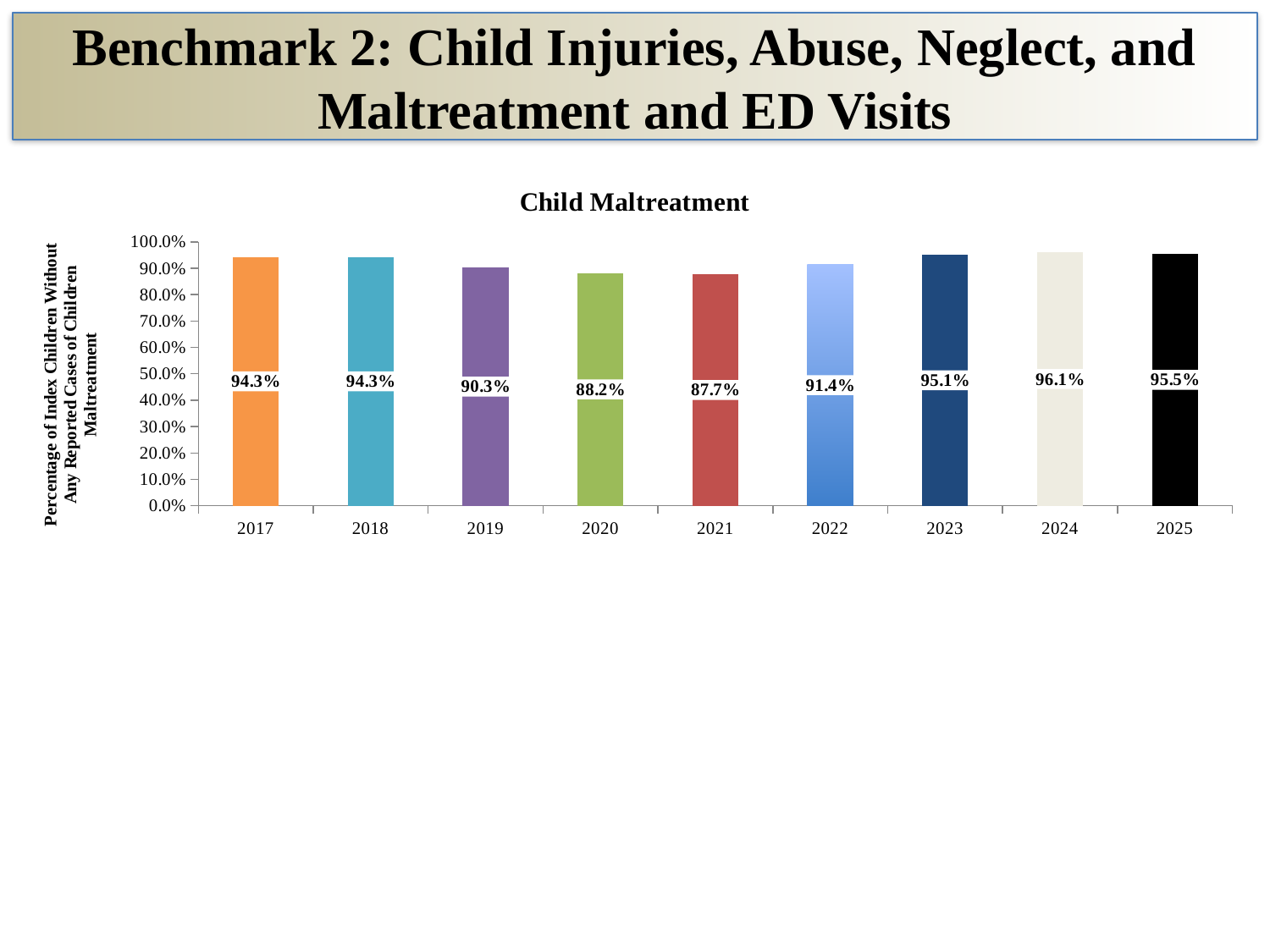
Which year has the highest value in the Child Maltreatment chart? 2024 Which year has the lowest value in the Child Maltreatment chart? 2021 Which is larger in the Child Maltreatment chart, the value for 2019 or the value for 2020? 2019 What is the value for 2021 in the Child Maltreatment chart? 87.7% What is the difference between the values for 2024 and 2021 in the Child Maltreatment chart? 8.4% What is the difference between the values for 2023 and 2022 in the Child Maltreatment chart? 3.7% What is the title of the chart on the slide? Child Maltreatment Is the value for 2020 in the Child Maltreatment chart greater or less than 90.0%? less What is the value for 2017 in the Child Maltreatment chart? 94.3% What kind of chart is the Child Maltreatment chart? bar chart What is the value for 2024 in the Child Maltreatment chart? 96.1% How many years are shown on the x axis of the Child Maltreatment chart? 9